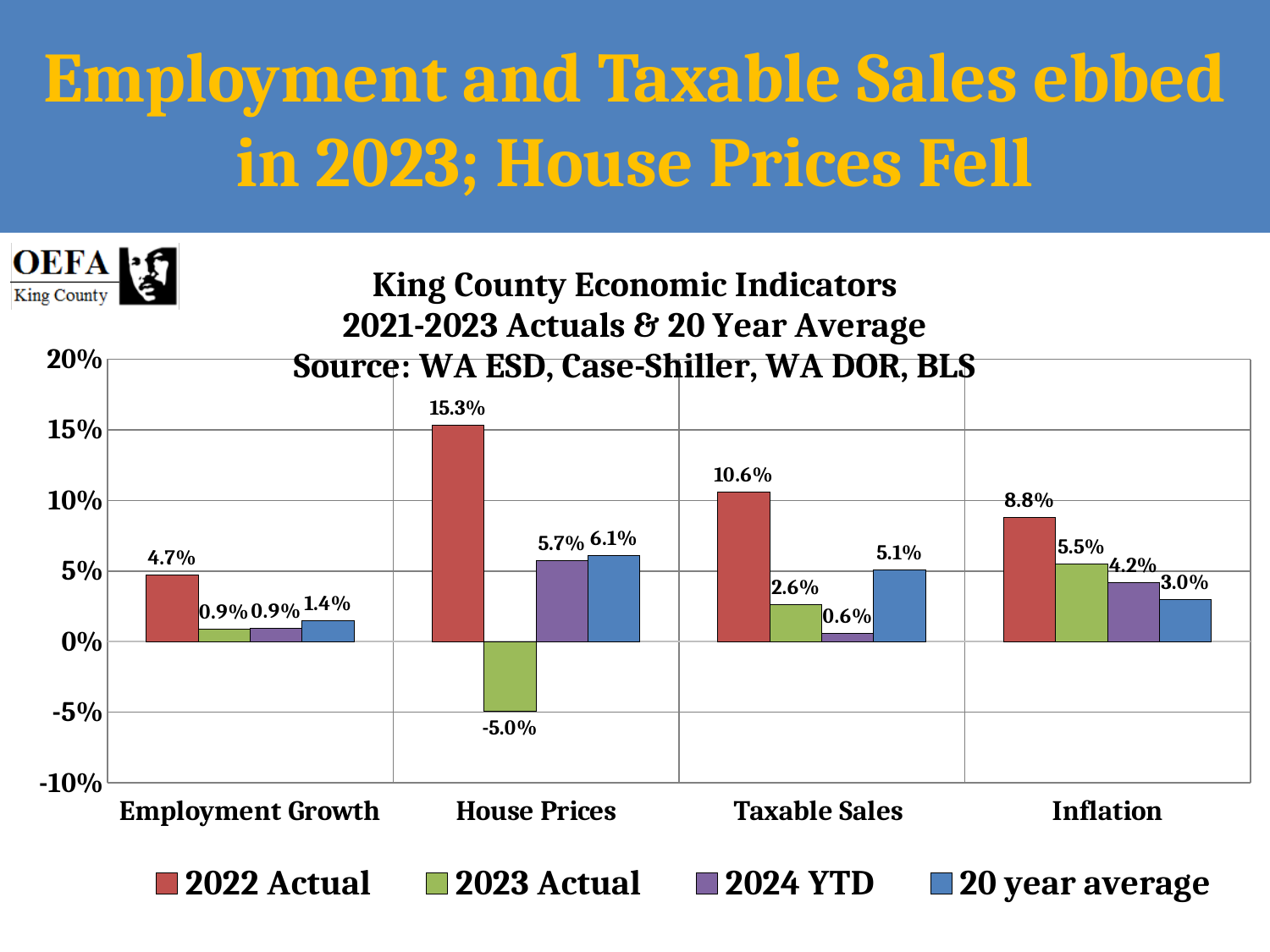
Which category has the highest 2022 Actual value? House Prices What is the 2023 Actual value for House Prices? -5.0% Which category has the lowest 2023 Actual value? House Prices How many categories are shown on the x axis? 4 What is the 20 year average value for Taxable Sales? 5.1% What kind of chart is shown on the slide? Bar chart What is the difference between the 2022 Actual and 2023 Actual values for Taxable Sales? 8.0% How many series does the legend list? 4 Which is larger for Inflation: the 2023 Actual value or the 20 year average? 2023 Actual What is the 2024 YTD value for Inflation? 4.2% Which series is shown in green in the legend? 2023 Actual What is the 2022 Actual value for House Prices? 15.3%